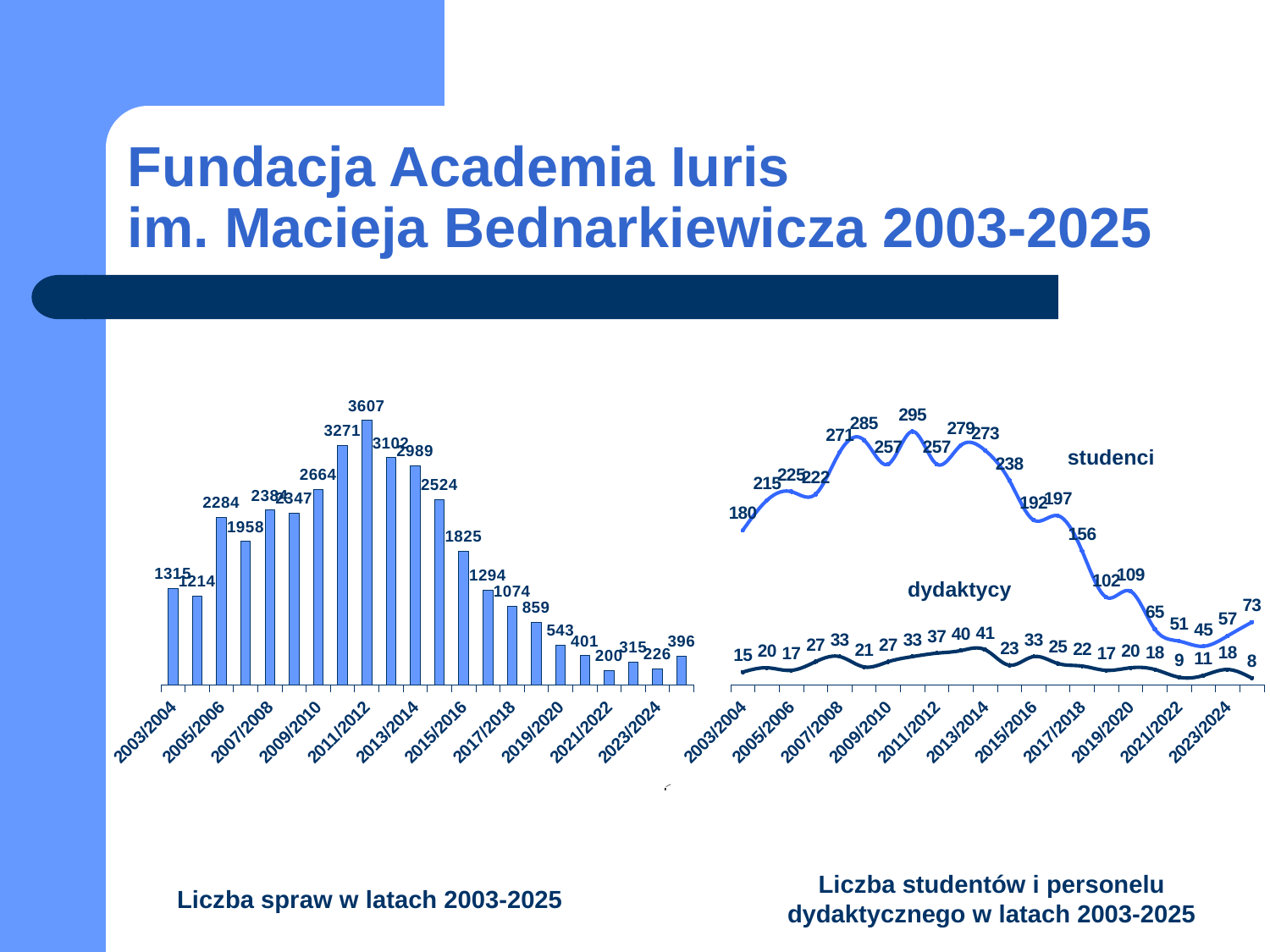
How many series are plotted in the right chart 'Liczba studentów i personelu dydaktycznego w latach 2003-2025'? 2 In the left chart 'Liczba spraw w latach 2003-2025', do the values generally rise or fall from 2011/2012 to 2021/2022? fall In the left chart 'Liczba spraw w latach 2003-2025', what is the difference between the highest value (3607) and the value just before it (3271)? 336 In the right chart, what is the highest value of the 'studenci' series? 295 In the left chart 'Liczba spraw w latach 2003-2025', what is the value for 2003/2004? 1315 In the right chart, what is the value of 'studenci' for 2003/2004? 180 What kind of chart is the right chart, 'Liczba studentów i personelu dydaktycznego w latach 2003-2025'? line chart In the left chart 'Liczba spraw w latach 2003-2025', what is the highest value shown? 3607 In the left chart 'Liczba spraw w latach 2003-2025', what is the lowest value shown? 200 In the right chart, which series has the larger value in 2003/2004, 'studenci' or 'dydaktycy'? studenci In the right chart, what is the lowest value of the 'dydaktycy' series? 8 What kind of chart is the left chart, 'Liczba spraw w latach 2003-2025'? bar chart